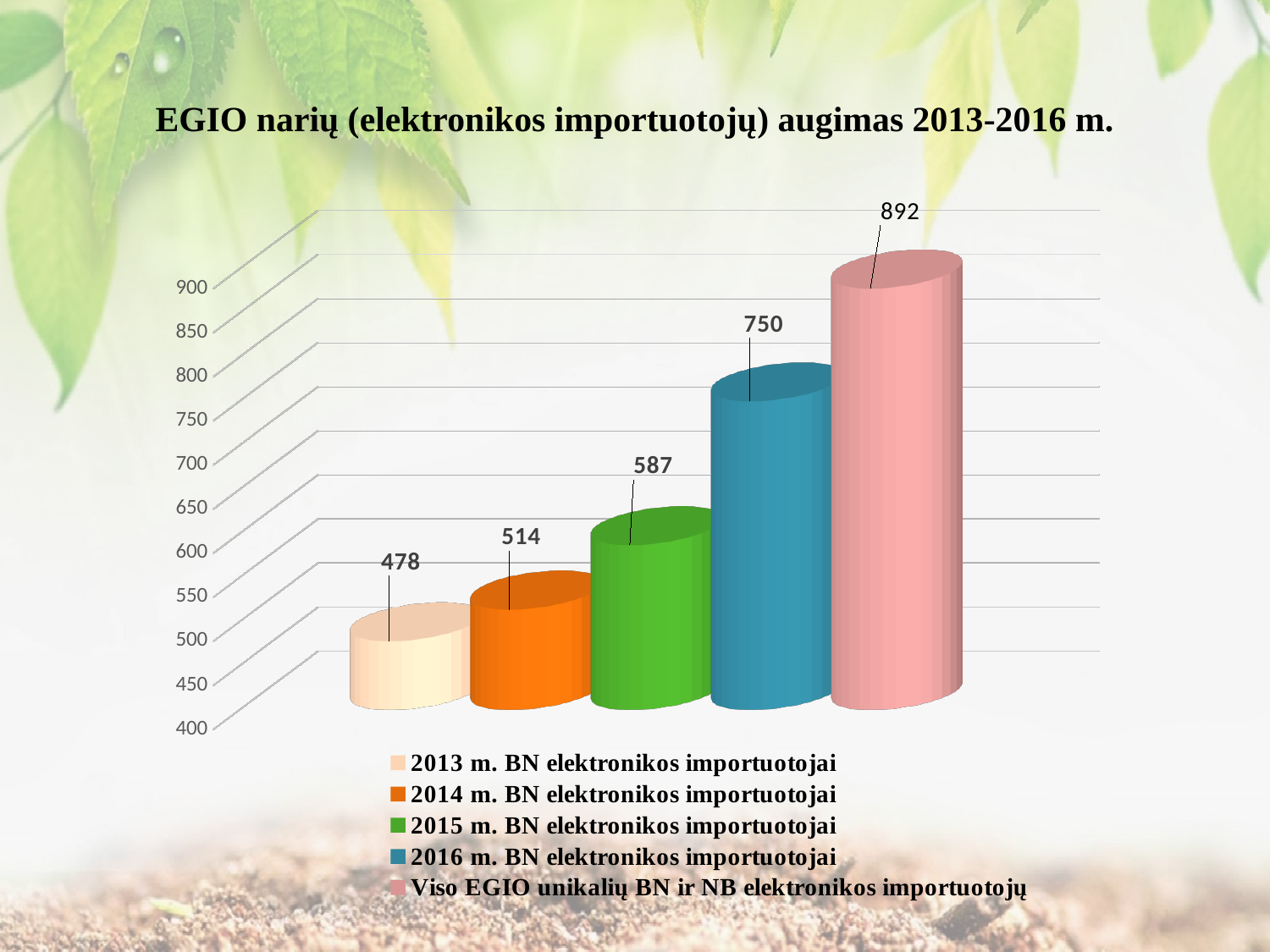
What is the difference between the 2016 m. value and the 2015 m. value? 163 What is the title of the chart? EGIO narių (elektronikos importuotojų) augimas 2013-2016 m. What is the difference between the 2014 m. value and the 2013 m. value? 36 Is the value for 2016 m. BN elektronikos importuotojai greater or less than 700? greater What is the value for 2013 m. BN elektronikos importuotojai? 478 What kind of chart is shown on the slide? bar chart How many bars are plotted in the chart? 5 Which is larger, the value for 2014 m. BN elektronikos importuotojai or the value for 2016 m. BN elektronikos importuotojai? 2016 m. BN elektronikos importuotojai What is the value for Viso EGIO unikalių BN ir NB elektronikos importuotojų? 892 Which legend entry has the lowest value? 2013 m. BN elektronikos importuotojai Which legend entry has the highest value? Viso EGIO unikalių BN ir NB elektronikos importuotojų What is the value for 2015 m. BN elektronikos importuotojai? 587